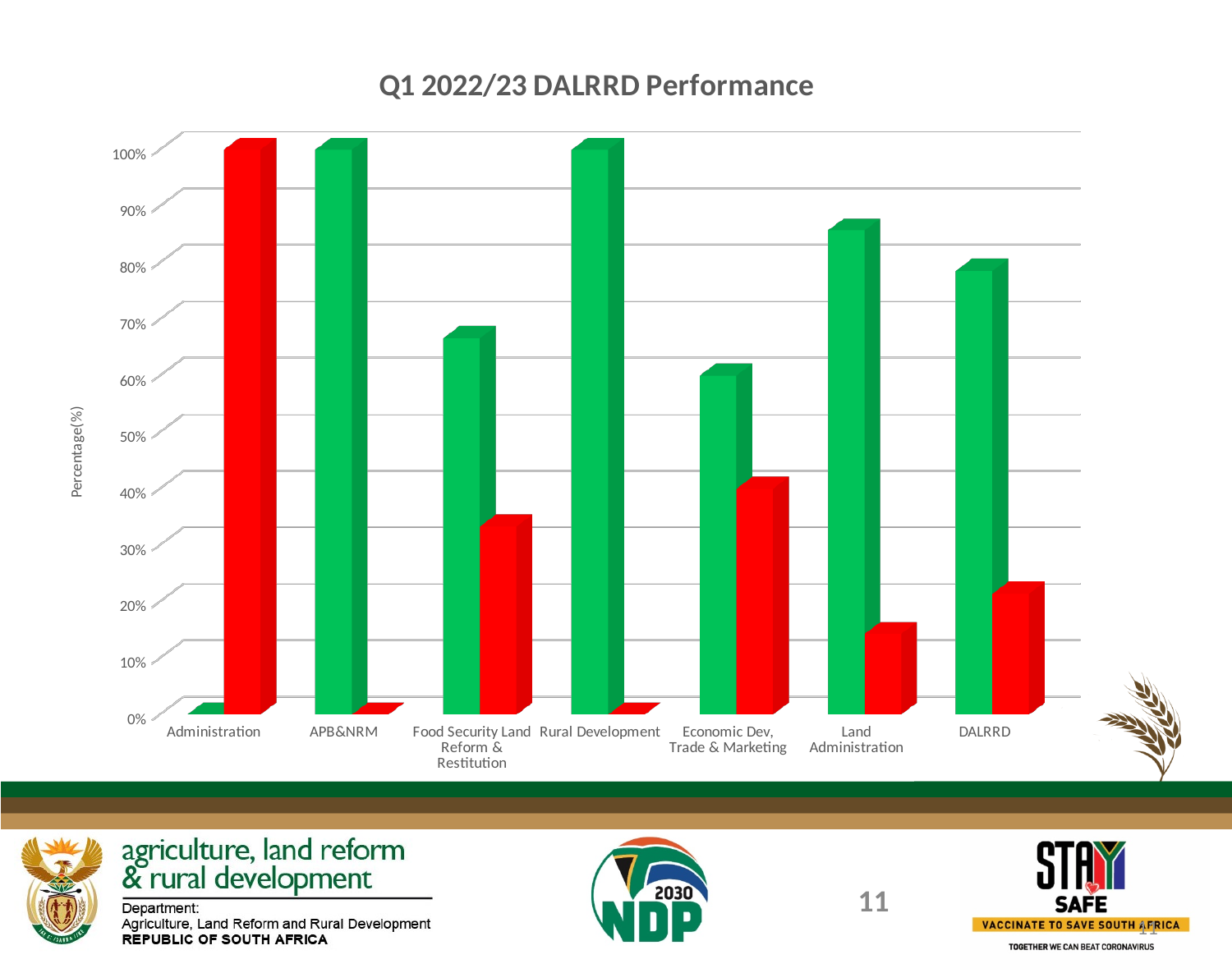
How many categories are shown on the x axis of the chart? 7 What is the value of the red bar for Administration? 100% Which category has the tallest red bar? Administration What is the title of the chart? Q1 2022/23 DALRRD Performance Is the red bar for Land Administration greater or less than 20%? less What kind of chart is shown on the slide? bar chart Is the green bar for Food Security Land Reform & Restitution greater or less than 60%? greater Which category has the lowest green bar? Administration What is the label of the y axis? Percentage(%) Is the green bar for DALRRD greater or less than 70%? greater What is the value of the green bar for Rural Development? 100% Which is larger, the green bar for Land Administration or the green bar for Economic Dev, Trade & Marketing? Land Administration